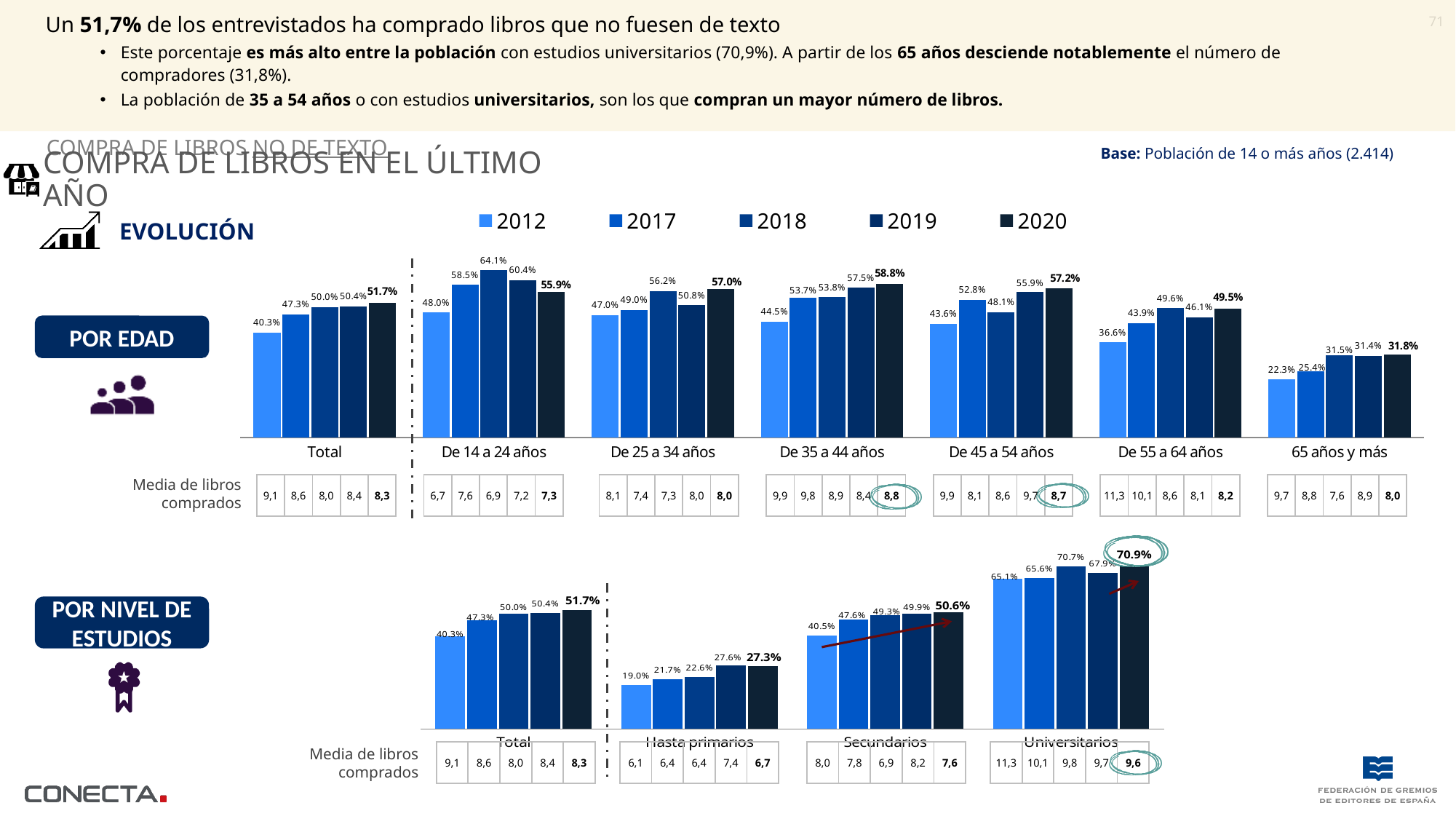
In the POR EDAD chart, what is the difference between the 2020 and 2012 values for Total? 11.4 percentage points In the POR EDAD chart, what is the 2012 value for De 14 a 24 años? 48.0% In the POR NIVEL DE ESTUDIOS chart, what is the 2012 value for Hasta primarios? 19.0% In the POR NIVEL DE ESTUDIOS chart, which is larger: the 2019 value for Secundarios or the 2019 value for Hasta primarios? Secundarios (49.9%) How many series does the legend list? 5 In the POR NIVEL DE ESTUDIOS chart, what is the 2020 value for Universitarios? 70.9% In the POR NIVEL DE ESTUDIOS chart, do the values for Secundarios rise or fall from 2012 to 2020? Rise In the POR EDAD chart, how many categories are shown on the x axis? 7 In the POR EDAD chart, which age category has the highest 2018 value? De 14 a 24 años In the POR EDAD chart, what is the 2020 value for 65 años y más? 31.8% What kind of chart is the POR NIVEL DE ESTUDIOS chart? Bar chart In the POR EDAD chart, which age category has the lowest 2020 value? 65 años y más